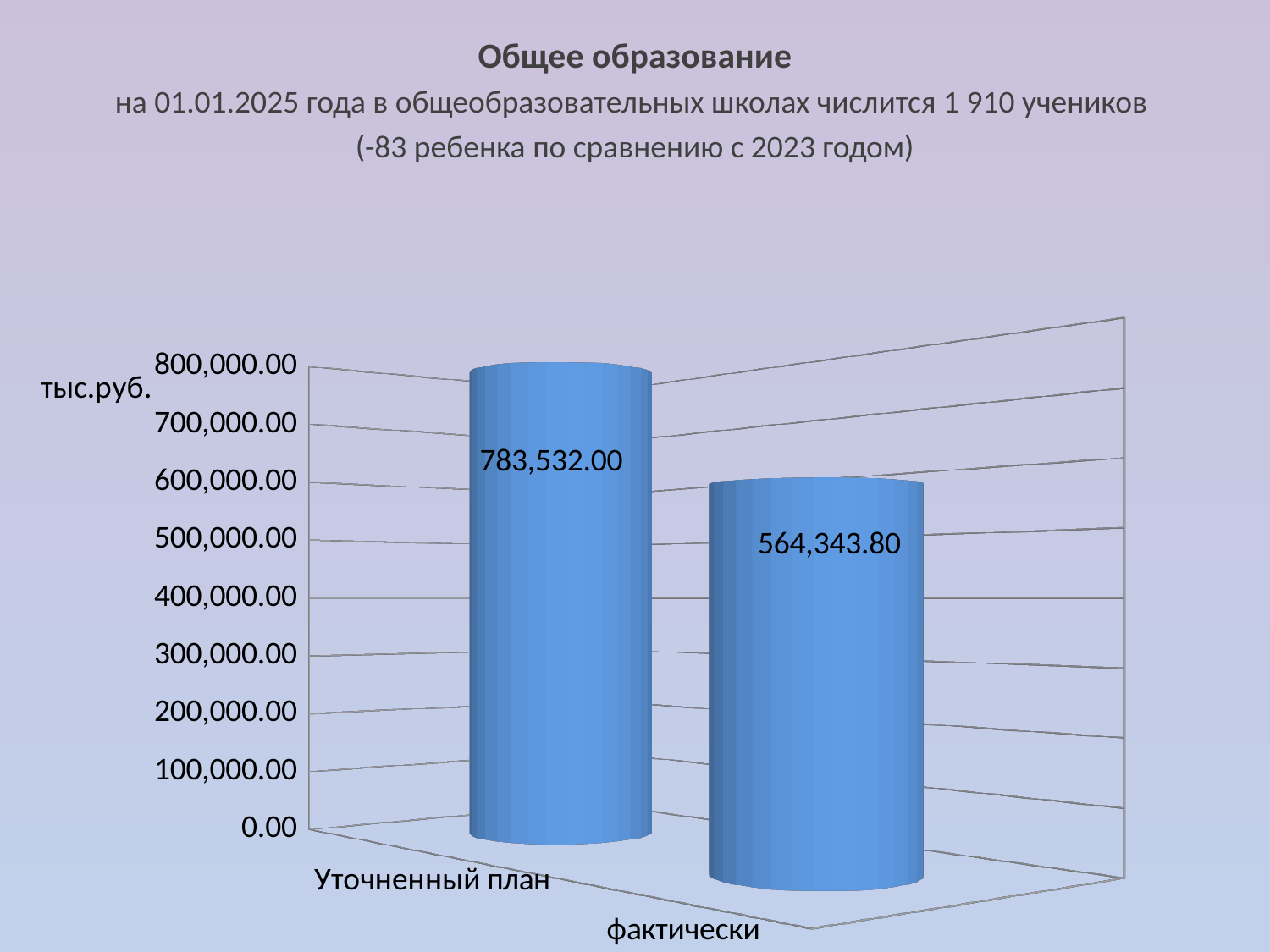
What unit is shown on the vertical axis of the chart? тыс.руб. Is the value for "Уточненный план" greater or less than 700,000.00? greater What is the difference between the values for "Уточненный план" and "фактически"? 219,188.20 What kind of chart is shown on the slide? bar chart How many categories are shown on the chart? 2 Which is larger, the value for "Уточненный план" or the value for "фактически"? Уточненный план What is the title of the slide containing the chart? Общее образование Which category has the lowest value? фактически What is the value for "Уточненный план"? 783,532.00 Is the value for "фактически" greater or less than 600,000.00? less Which category has the highest value? Уточненный план What is the value for "фактически"? 564,343.80